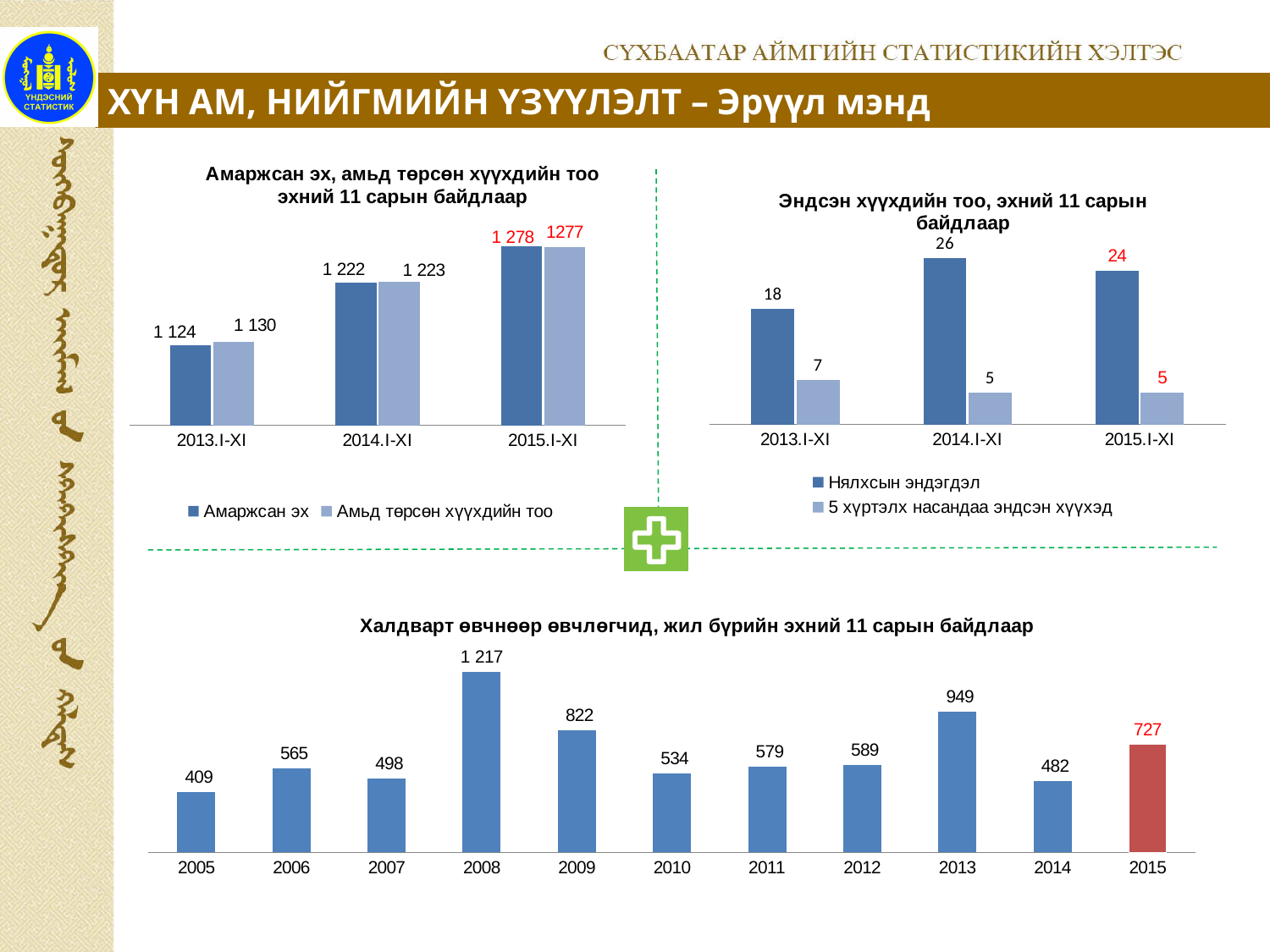
In the bottom chart (Халдварт өвчнөөр өвчлөгчид), which year has the lowest value? 2005 In the top-left chart (Амаржсан эх, амьд төрсөн хүүхдийн тоо), what is the value for Амаржсан эх in 2015.I-XI? 1 278 In the top-right chart (Эндсэн хүүхдийн тоо), which period has the highest value for Нялхсын эндэгдэл? 2014.I-XI In the bottom chart (Халдварт өвчнөөр өвчлөгчид), what is the value for 2008? 1 217 In the bottom chart (Халдварт өвчнөөр өвчлөгчид), which is larger, the value for 2013 or the value for 2015? 2013 In the top-left chart (Амаржсан эх, амьд төрсөн хүүхдийн тоо), how many series does the legend list? 2 In the top-right chart (Эндсэн хүүхдийн тоо), what is the value for Нялхсын эндэгдэл in 2014.I-XI? 26 In the top-left chart (Амаржсан эх, амьд төрсөн хүүхдийн тоо), what is the value for Амьд төрсөн хүүхдийн тоо in 2013.I-XI? 1 130 In the top-right chart (Эндсэн хүүхдийн тоо), what is the value for 5 хүртэлх насандаа эндсэн хүүхэд in 2013.I-XI? 7 In the top-left chart (Амаржсан эх, амьд төрсөн хүүхдийн тоо), what is the difference between Амаржсан эх in 2014.I-XI and 2013.I-XI? 98 In the bottom chart (Халдварт өвчнөөр өвчлөгчид), how many years are shown on the x axis? 11 What kind of chart is the bottom chart (Халдварт өвчнөөр өвчлөгчид)? Bar chart